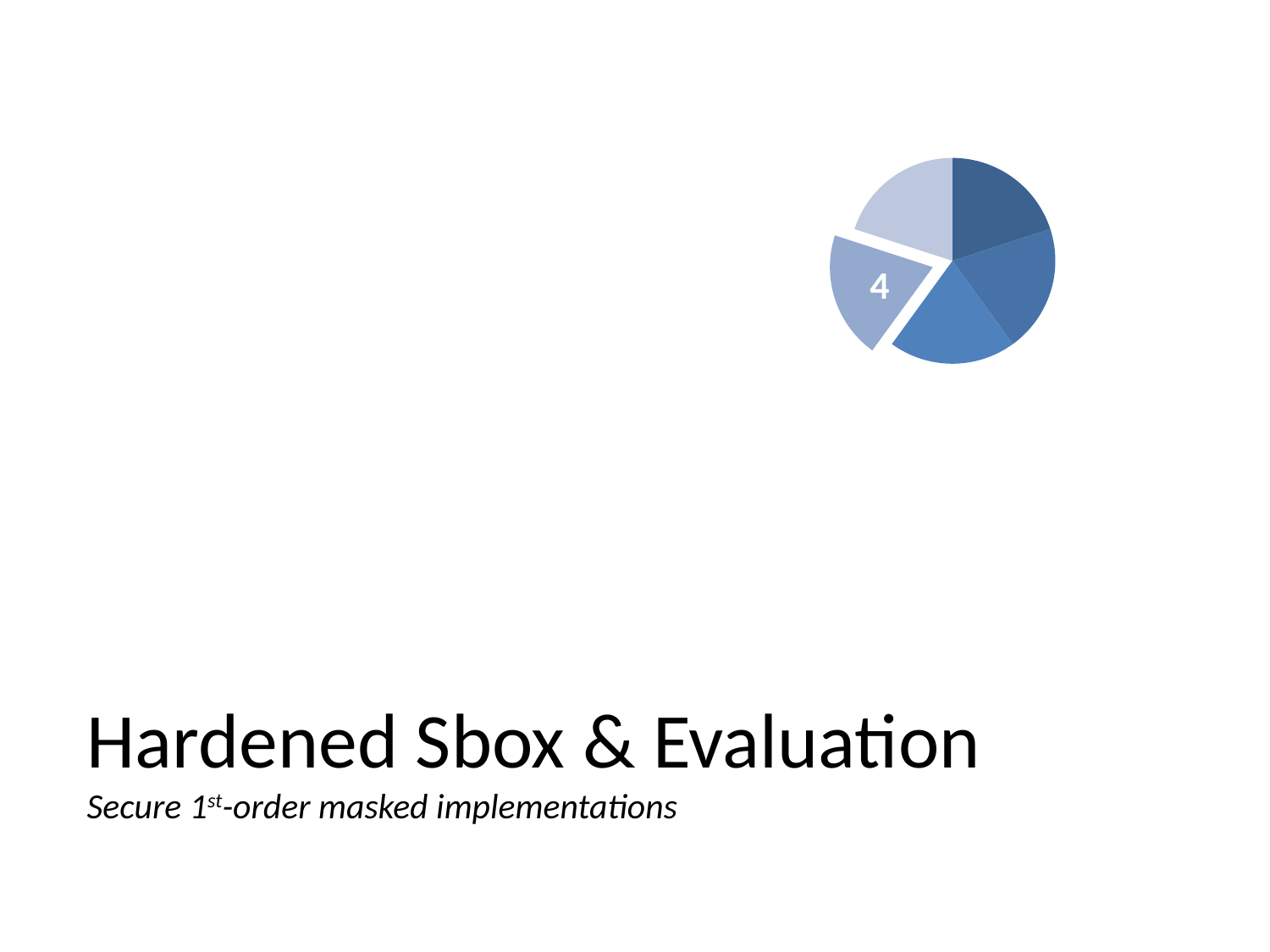
How many slices of the pie chart are pulled out (exploded) from the rest? 1 What data label is printed on the slice that is pulled out from the pie? 4 How many slices does the pie chart have? 5 What kind of chart is shown on the slide? pie chart Does the pie chart display a legend? No